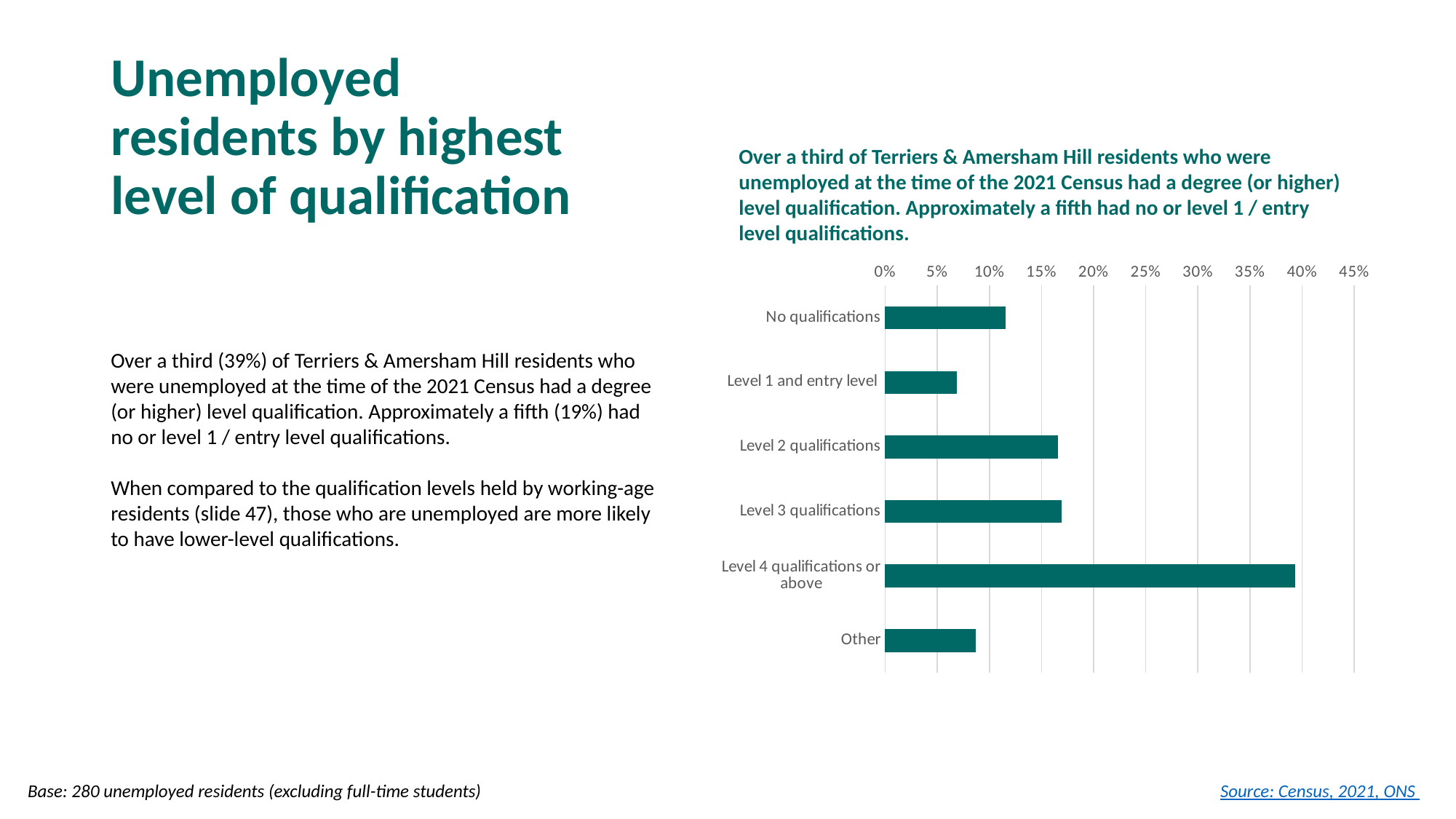
Which qualification category has the highest value in the chart? Level 4 qualifications or above Which is larger, the value for Level 4 qualifications or above or the value for No qualifications? Level 4 qualifications or above How many qualification categories are plotted in the chart? 6 Which is larger, the value for Level 2 qualifications or the value for Level 1 and entry level? Level 2 qualifications What kind of chart is shown on the slide? Bar chart Is the value for Level 2 qualifications greater or less than 15%? greater Is the value for Level 4 qualifications or above greater or less than 35%? greater What is the highest tick value shown on the chart's percentage axis? 45% Is the value for Level 1 and entry level greater or less than 10%? less